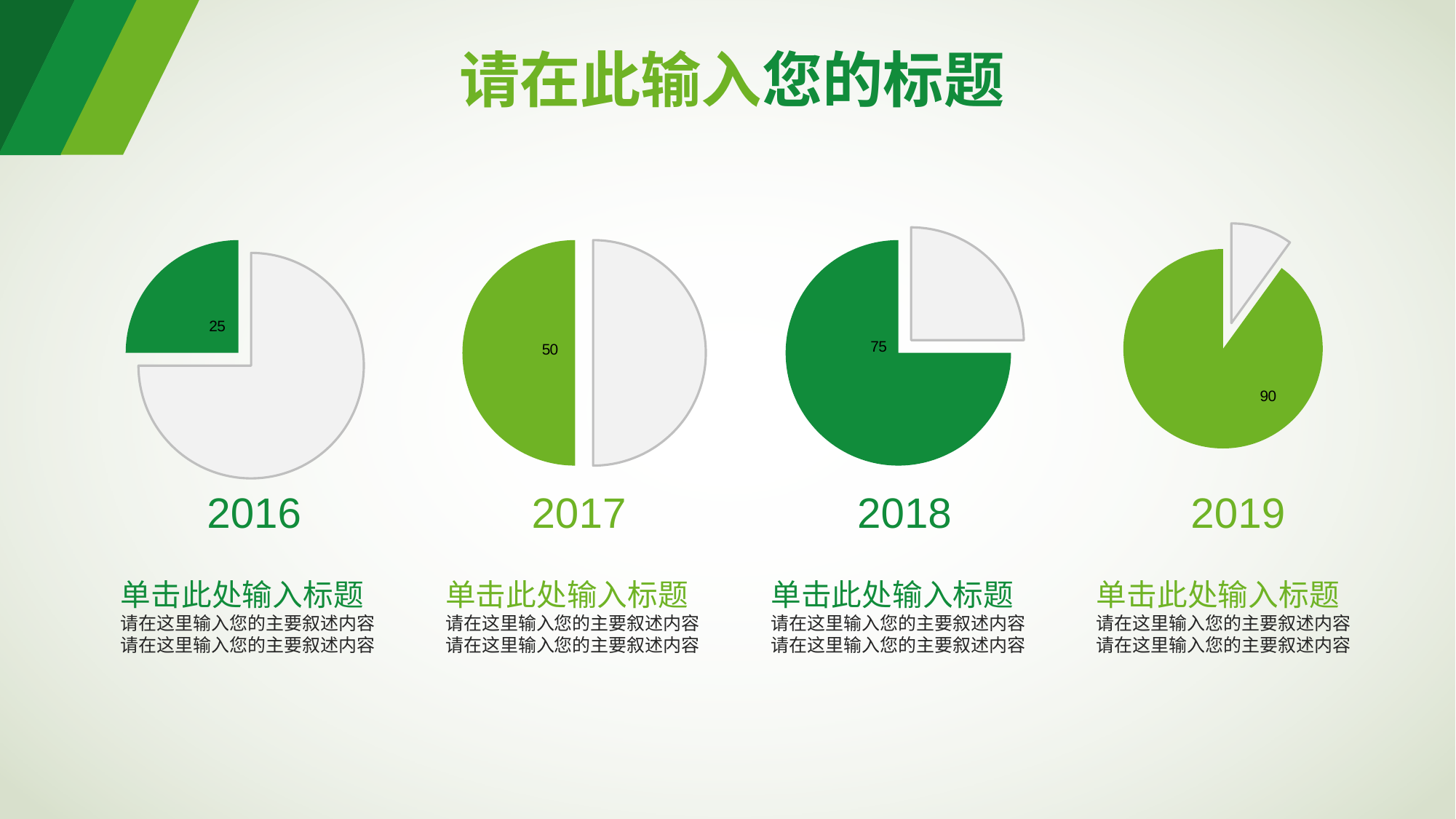
What value is labelled on the green slice of the 2017 pie chart? 50 How many pie charts are shown on the slide? 4 What is the difference between the labelled value in the 2019 pie chart and the labelled value in the 2016 pie chart? 65 What value is labelled on the green slice of the 2016 pie chart? 25 What value is labelled on the green slice of the 2018 pie chart? 75 Which is larger, the labelled value in the 2017 pie chart or the labelled value in the 2018 pie chart? 2018 What value is labelled on the green slice of the 2019 pie chart? 90 What is the difference between the labelled value in the 2018 pie chart and the labelled value in the 2017 pie chart? 25 What kind of chart is used for each year on the slide? Pie chart Which year's pie chart has the smallest labelled green slice? 2016 Do the labelled values rise or fall from 2016 to 2019? Rise Which year's pie chart has the largest labelled green slice? 2019